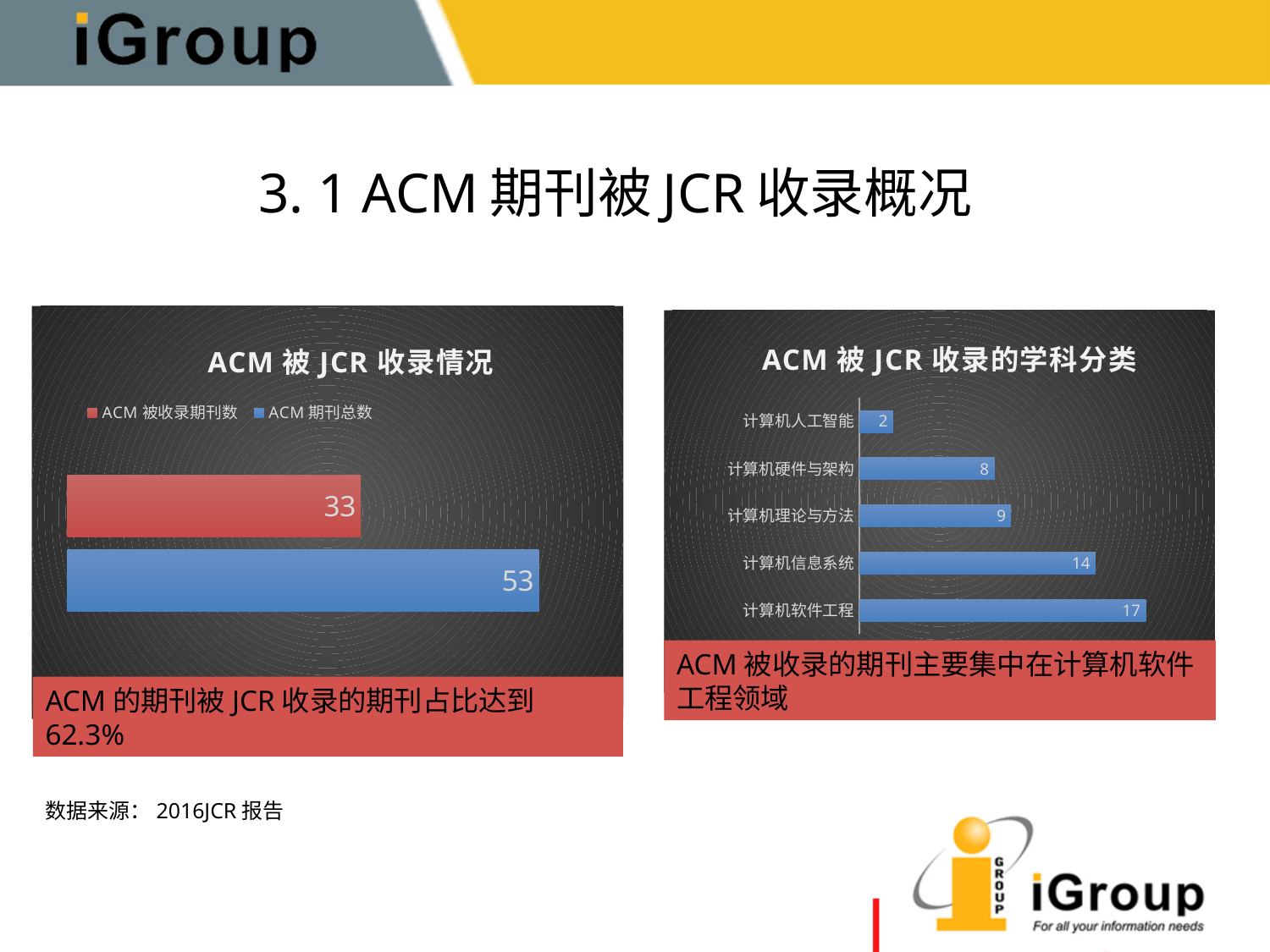
In the chart titled "ACM 被 JCR 收录情况", what is the value for ACM 被收录期刊数? 33 What kind of chart is the chart titled "ACM 被 JCR 收录的学科分类"? Bar chart In the chart titled "ACM 被 JCR 收录情况", what is the value for ACM 期刊总数? 53 In the chart titled "ACM 被 JCR 收录的学科分类", what is the difference between 计算机信息系统 and 计算机硬件与架构? 6 In the chart titled "ACM 被 JCR 收录的学科分类", which category has the lowest value? 计算机人工智能 In the chart titled "ACM 被 JCR 收录的学科分类", which category has the highest value? 计算机软件工程 In the chart titled "ACM 被 JCR 收录情况", what colour is the bar for ACM 被收录期刊数? Red In the chart titled "ACM 被 JCR 收录的学科分类", how many categories are shown? 5 In the chart titled "ACM 被 JCR 收录的学科分类", what is the value for 计算机软件工程? 17 In the chart titled "ACM 被 JCR 收录的学科分类", what is the value for 计算机人工智能? 2 In the chart titled "ACM 被 JCR 收录情况", how many series does the legend list? 2 In the chart titled "ACM 被 JCR 收录情况", what is the difference between ACM 期刊总数 and ACM 被收录期刊数? 20